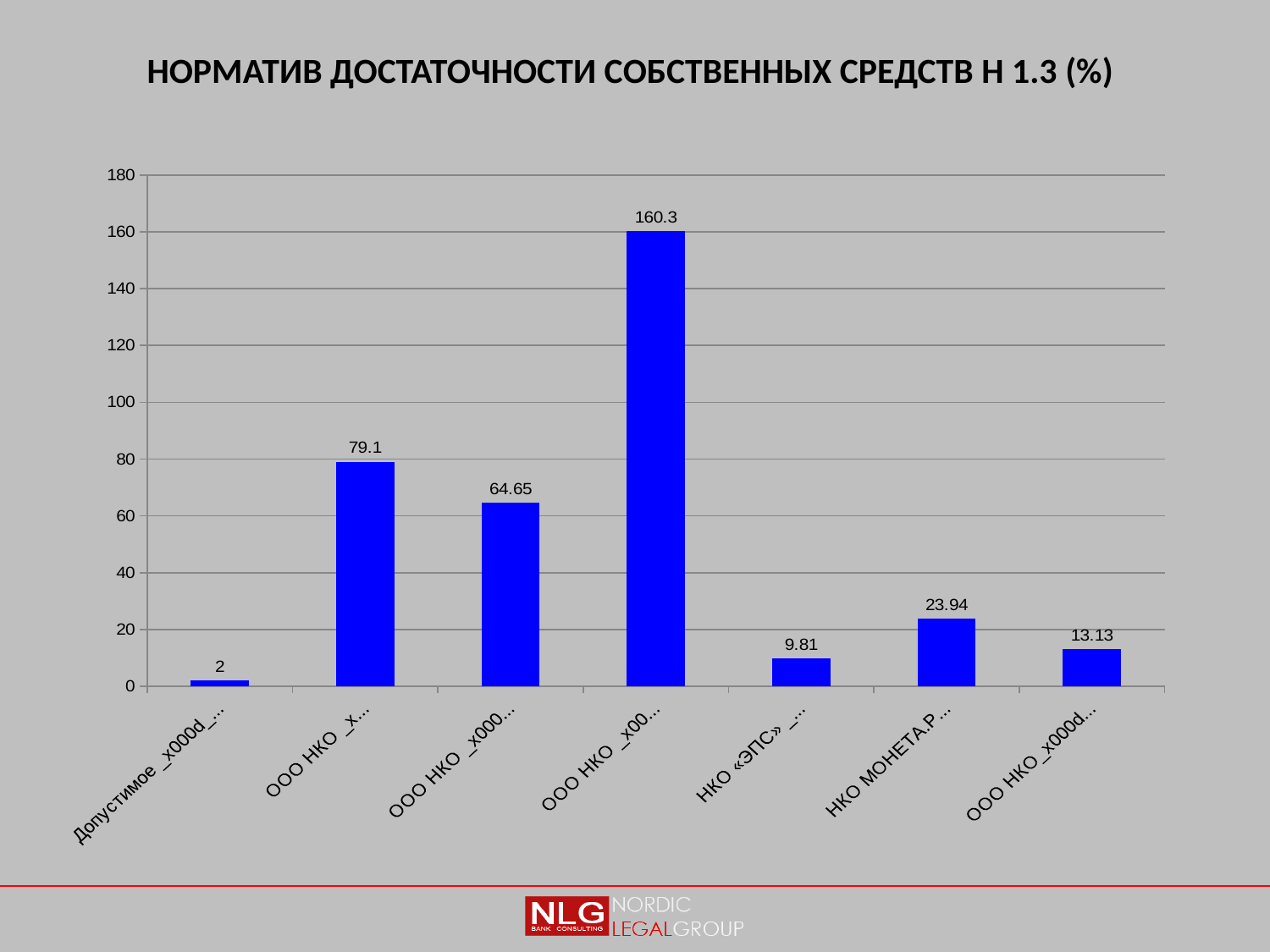
What is the value of the last bar on the right? 13.13 What is the value of the bar labelled НКО «ЭПС»? 9.81 Which bar has the lowest value in the chart? the first bar (Допустимое) What is the value of the bar labelled НКО МОНЕТА.Р? 23.94 What is the difference between the second bar (79.1) and the third bar (64.65)? 14.45 How many bars are plotted in the chart? 7 What is the value of the first bar (Допустимое)? 2 What is the value of the second bar from the left? 79.1 Which is larger: the value for НКО МОНЕТА.Р or the value for НКО «ЭПС»? НКО МОНЕТА.Р What is the title of the chart? НОРМАТИВ ДОСТАТОЧНОСТИ СОБСТВЕННЫХ СРЕДСТВ Н 1.3 (%) What is the value of the highest bar in the chart? 160.3 What type of chart is shown on the slide? bar chart